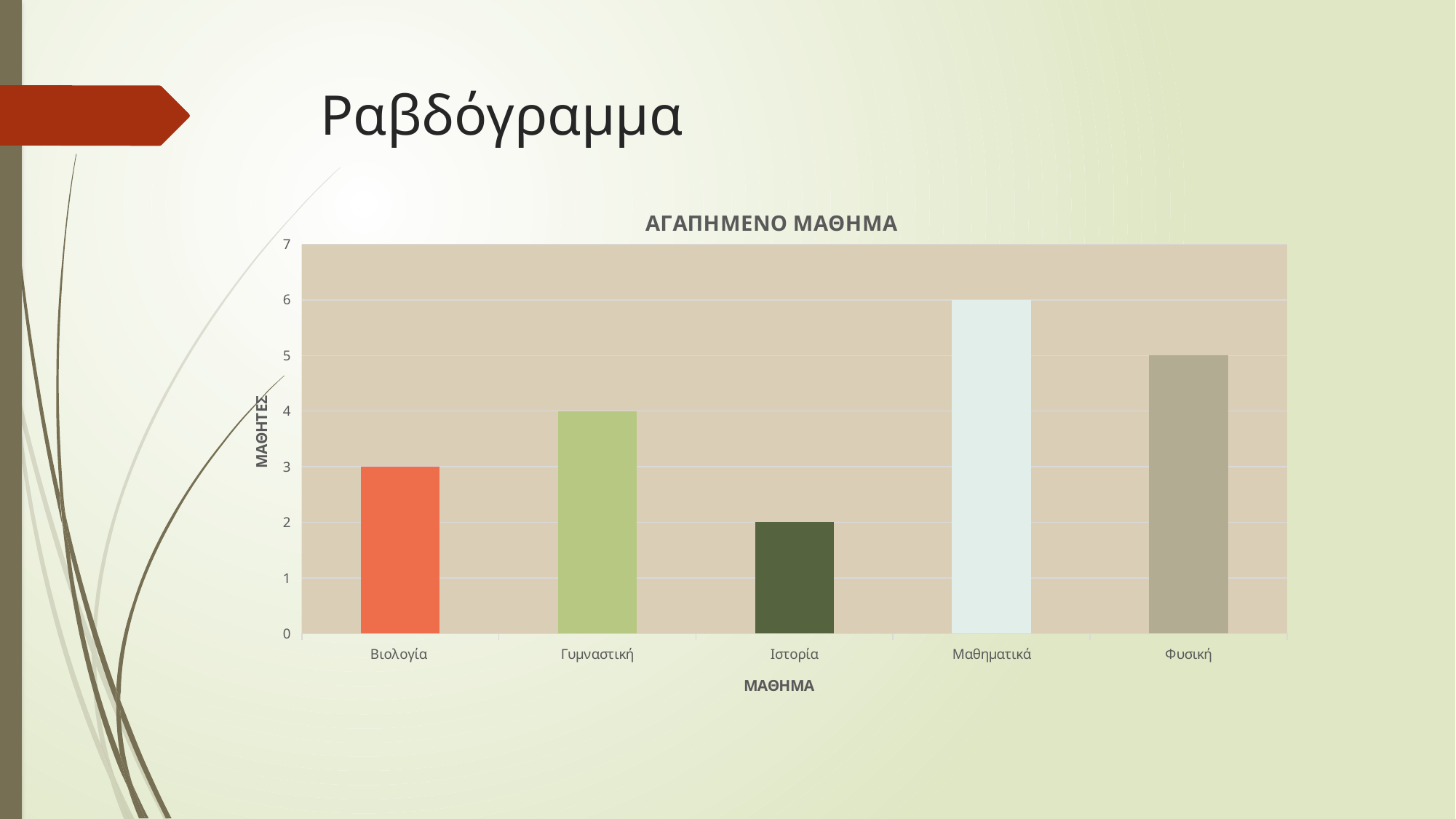
What is the difference between the values for Μαθηματικά and Βιολογία? 3 What is the value for Μαθηματικά? 6 What is the value for Ιστορία? 2 What kind of chart is shown? bar chart What is the value for Βιολογία? 3 Is the value for Φυσική greater or less than 4? greater What is the title of the chart? ΑΓΑΠΗΜΕΝΟ ΜΑΘΗΜΑ What is the label of the vertical axis? ΜΑΘΗΤΕΣ Which category has the highest value? Μαθηματικά How many categories are shown on the x axis? 5 Which category has the lowest value? Ιστορία Which is larger, the value for Γυμναστική or the value for Φυσική? Φυσική